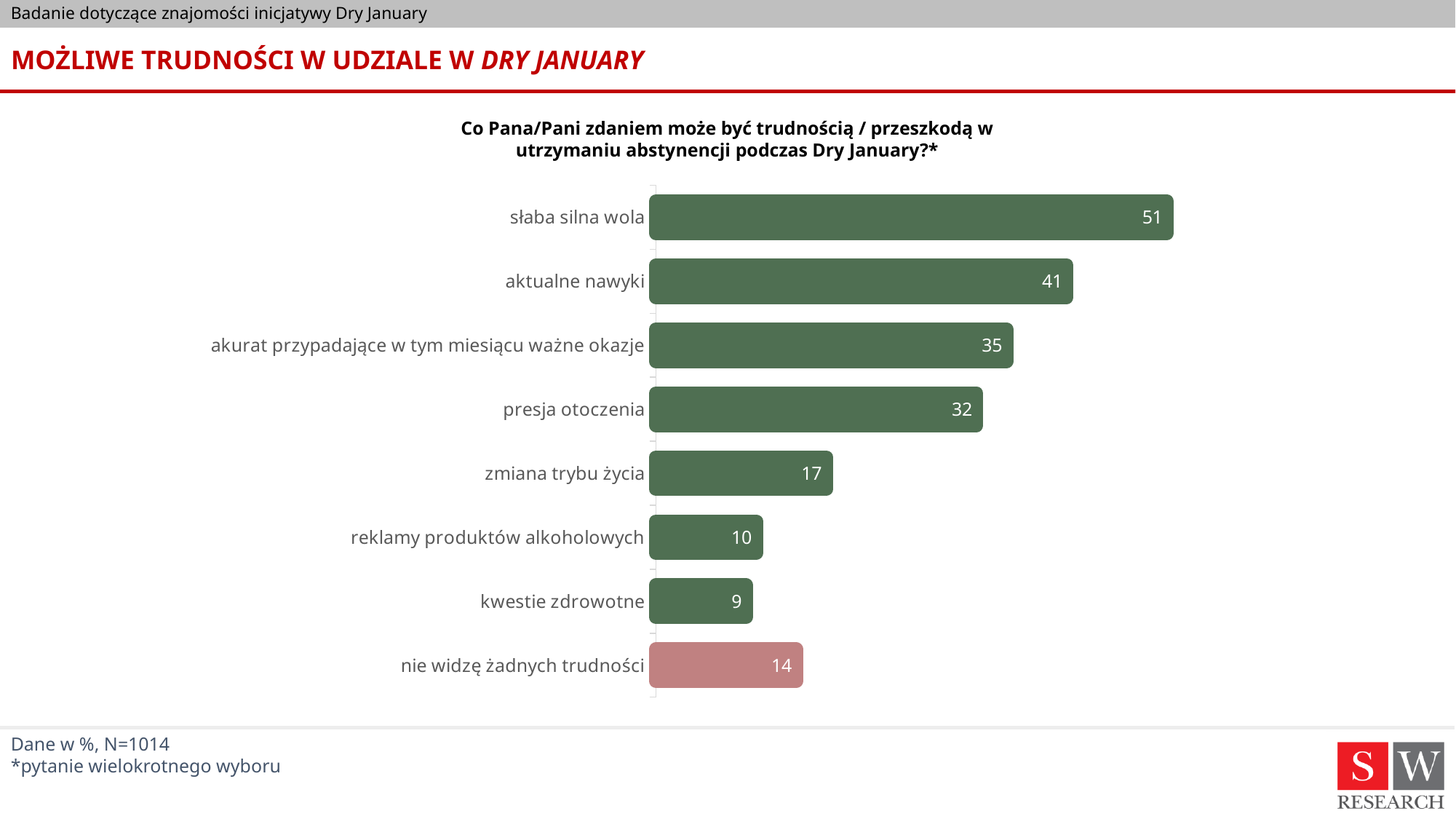
What is the difference between the values for "słaba silna wola" and "aktualne nawyki"? 10 What kind of chart is shown on the slide? bar chart Which category has the lowest value? kwestie zdrowotne What is the value for "presja otoczenia"? 32 Which category has the highest value? słaba silna wola What is the value for "nie widzę żadnych trudności"? 14 Which is larger: the value for "zmiana trybu życia" or the value for "nie widzę żadnych trudności"? zmiana trybu życia Which category's bar is shown in a different colour (pink) from the others? nie widzę żadnych trudności What is the difference between the values for "akurat przypadające w tym miesiącu ważne okazje" and "presja otoczenia"? 3 What is the value for "słaba silna wola"? 51 What is the value for "reklamy produktów alkoholowych"? 10 How many categories are shown in the chart? 8